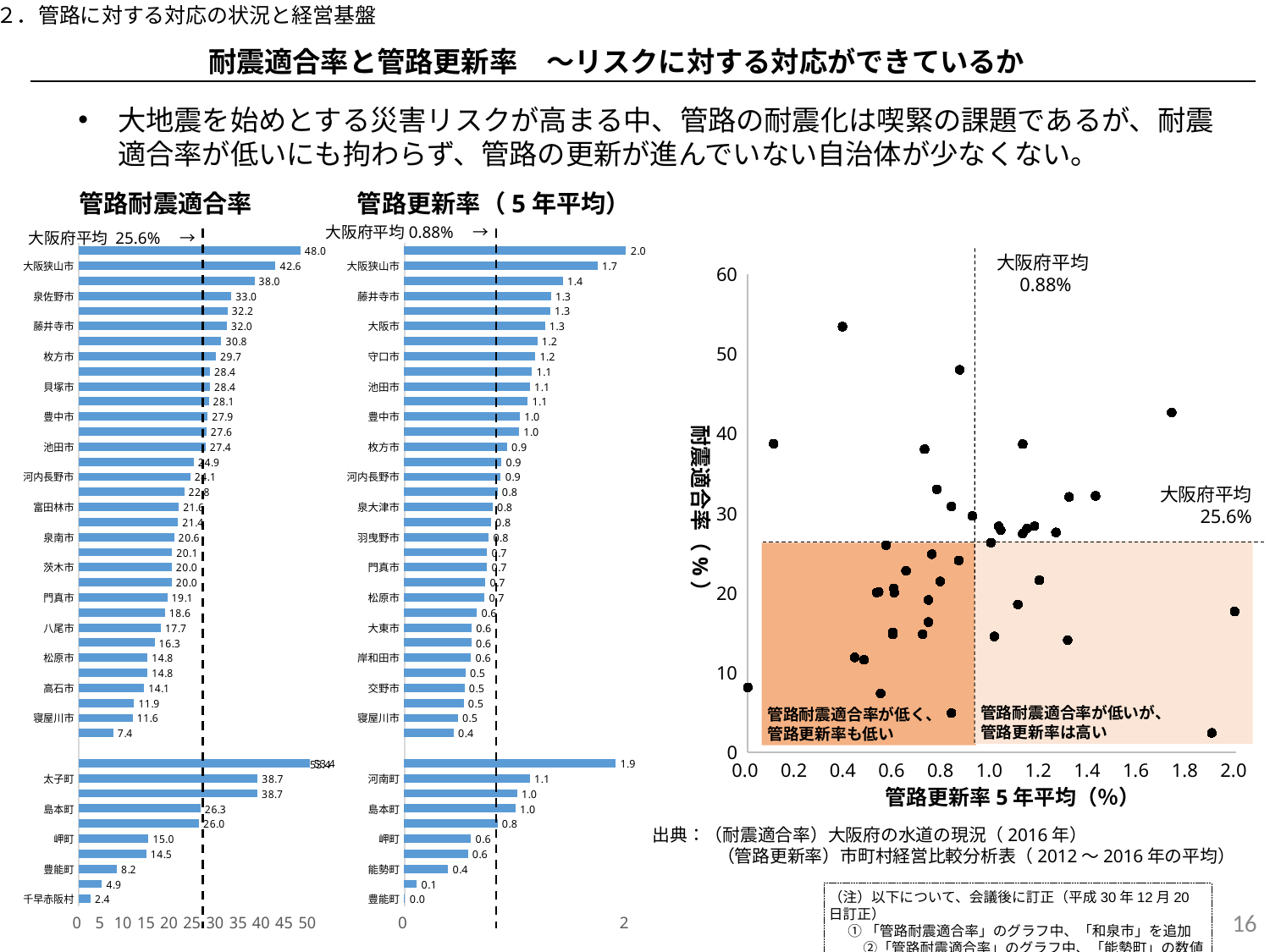
In the 管路耐震適合率 bar chart on the left, what is the value for 大阪狭山市? 42.6 In the 管路耐震適合率 bar chart on the left, what is the value for 太子町? 38.7 In the 管路更新率（5年平均） bar chart in the middle, what is the value for 河南町? 1.1 In the 管路更新率（5年平均） bar chart in the middle, what is the value for 豊能町? 0.0 What is the 大阪府平均 value shown for 管路耐震適合率 on the slide? 25.6% In the 管路耐震適合率 bar chart on the left, which is larger, the value for 泉佐野市 or the value for 枚方市? 泉佐野市 In the 管路耐震適合率 bar chart on the left, what is the value for 千早赤阪村? 2.4 What is the 大阪府平均 value shown for 管路更新率 on the slide? 0.88% In the 管路耐震適合率 bar chart on the left, what is the difference between the values for 豊中市 and 寝屋川市? 16.3 In the 管路更新率（5年平均） bar chart in the middle, what is the value for 大阪狭山市? 1.7 What kind of chart is the chart on the right of the slide? scatter plot In the 管路更新率（5年平均） bar chart in the middle, which is larger, the value for 守口市 or the value for 松原市? 守口市